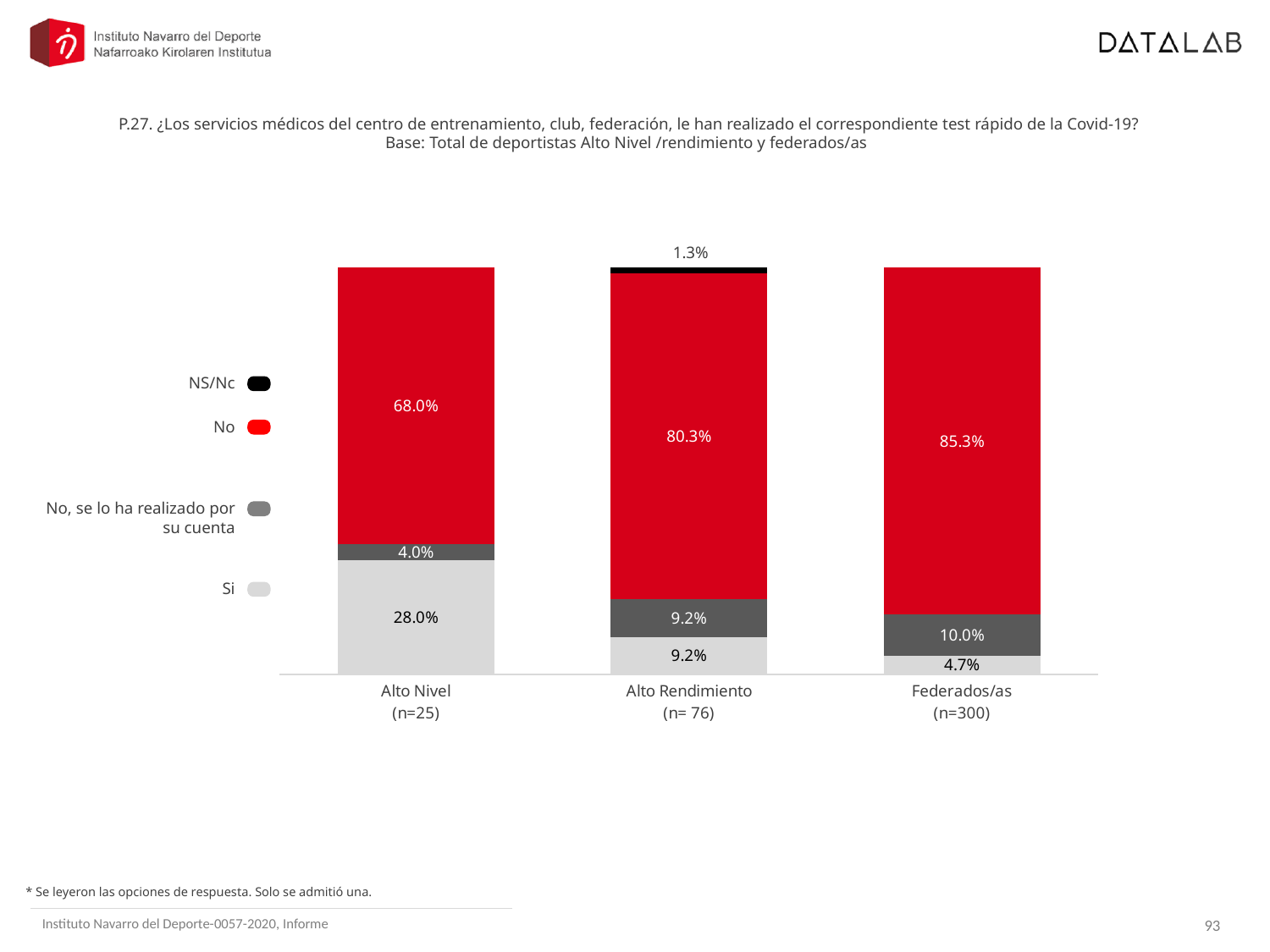
Which group has the highest "No" percentage? Federados/as How many groups (bars) are shown on the x axis? 3 Which is larger: the "Si" value for Alto Nivel or the "Si" value for Alto Rendimiento? Alto Nivel What type of chart is shown on the slide? Stacked bar chart How many response categories does the legend list? 4 What percentage of Federados/as answered "No, se lo ha realizado por su cuenta"? 10.0% Which group has the lowest "Si" percentage? Federados/as What is the "Si" value for Alto Rendimiento (n= 76)? 9.2% What is the difference between the "No" percentages for Federados/as and Alto Nivel? 17.3% What percentage of Alto Nivel athletes answered "No"? 68.0% Which colour represents the "No" response in the chart? Red What is the NS/Nc value shown for Alto Rendimiento? 1.3%